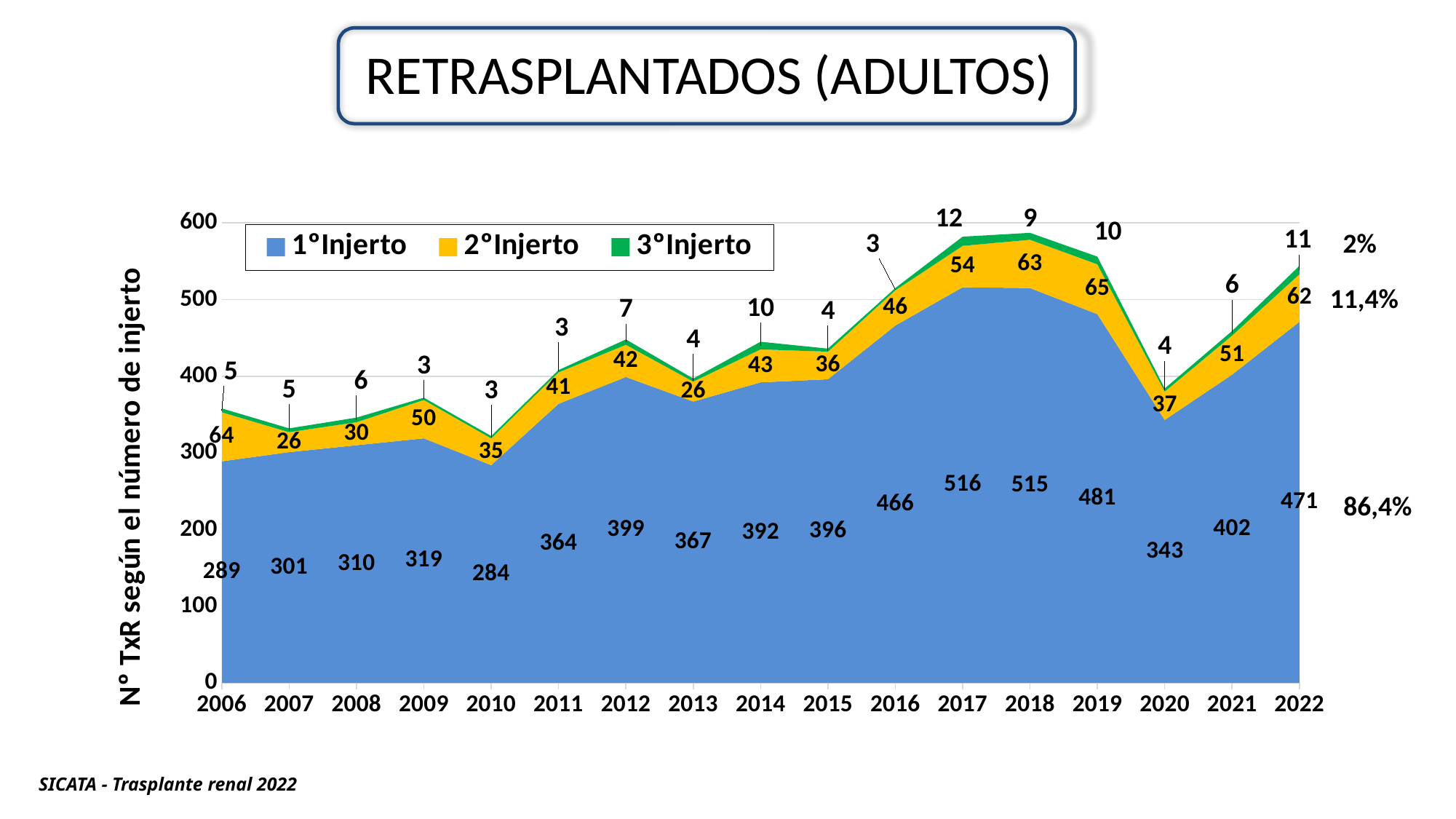
What is the value of 2°Injerto in 2006? 64 Which is larger, the 1°Injerto value in 2016 or in 2019? 2019 What kind of chart is shown on the slide? Stacked area chart How many years are shown on the x axis? 17 In which year is the 2°Injerto value the highest? 2019 What is the difference between the 2°Injerto values in 2022 and 2021? 11 In which year is the 3°Injerto value the highest? 2017 What is the total of all three series in 2022? 544 How many series does the legend list? 3 What is the value of 1°Injerto in 2017? 516 In which year is the 1°Injerto value the lowest? 2010 What is the value of 3°Injerto in 2022? 11